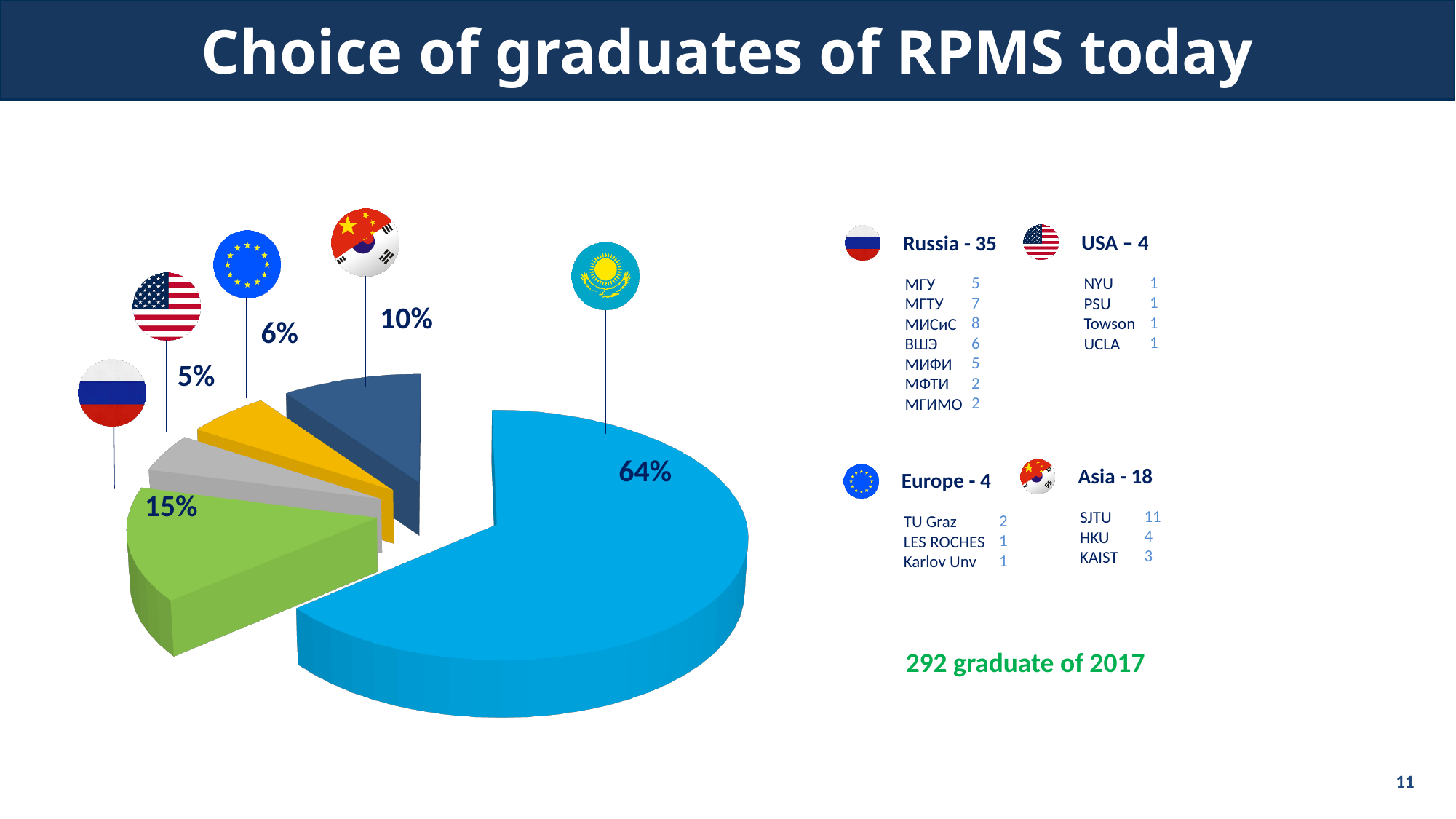
What percentage is shown for the pie slice marked with the Kazakhstan flag? 64% What percentage is shown for the pie slice marked with the Chinese/Korean flag? 10% How many slices does the pie chart have? 5 What percentage is shown for the pie slice marked with the EU flag? 6% What percentage is shown for the pie slice marked with the US flag? 5% What is the smallest percentage shown on the pie chart? 5% What is the difference in percentage points between the largest slice (64%) and the slice marked with the Russian flag (15%)? 49 What is the largest percentage shown on the pie chart? 64% Which slice is larger: the one marked with the EU flag or the one marked with the US flag? EU flag What is the title of the slide containing the pie chart? Choice of graduates of RPMS today What percentage is shown for the pie slice marked with the Russian flag? 15% What kind of chart is shown on the slide? Pie chart